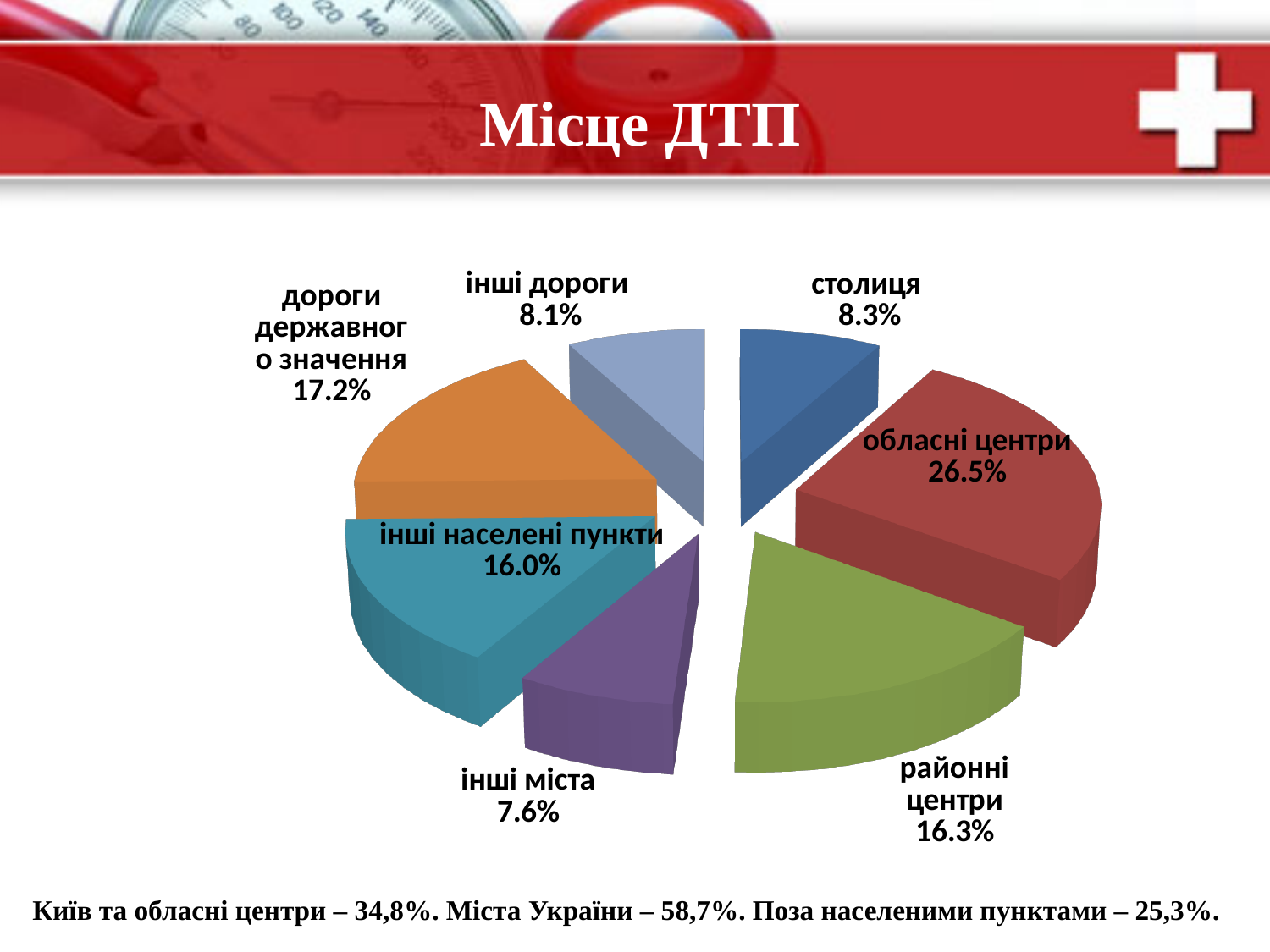
How many categories are shown in the pie chart? 7 What is the title of the chart on the slide? Місце ДТП What is the share for дороги державного значення? 17.2% Which category has the largest slice of the pie? обласні центри What is the share for інші міста? 7.6% Which is larger, the share for дороги державного значення or the share for інші населені пункти? дороги державного значення What is the share for обласні центри? 26.5% What kind of chart is shown on the slide? pie chart What is the share for столиця? 8.3% What is the difference between the shares for обласні центри and районні центри? 10.2% Which category has the smallest slice of the pie? інші міста What is the difference between the shares for столиця and інші дороги? 0.2%